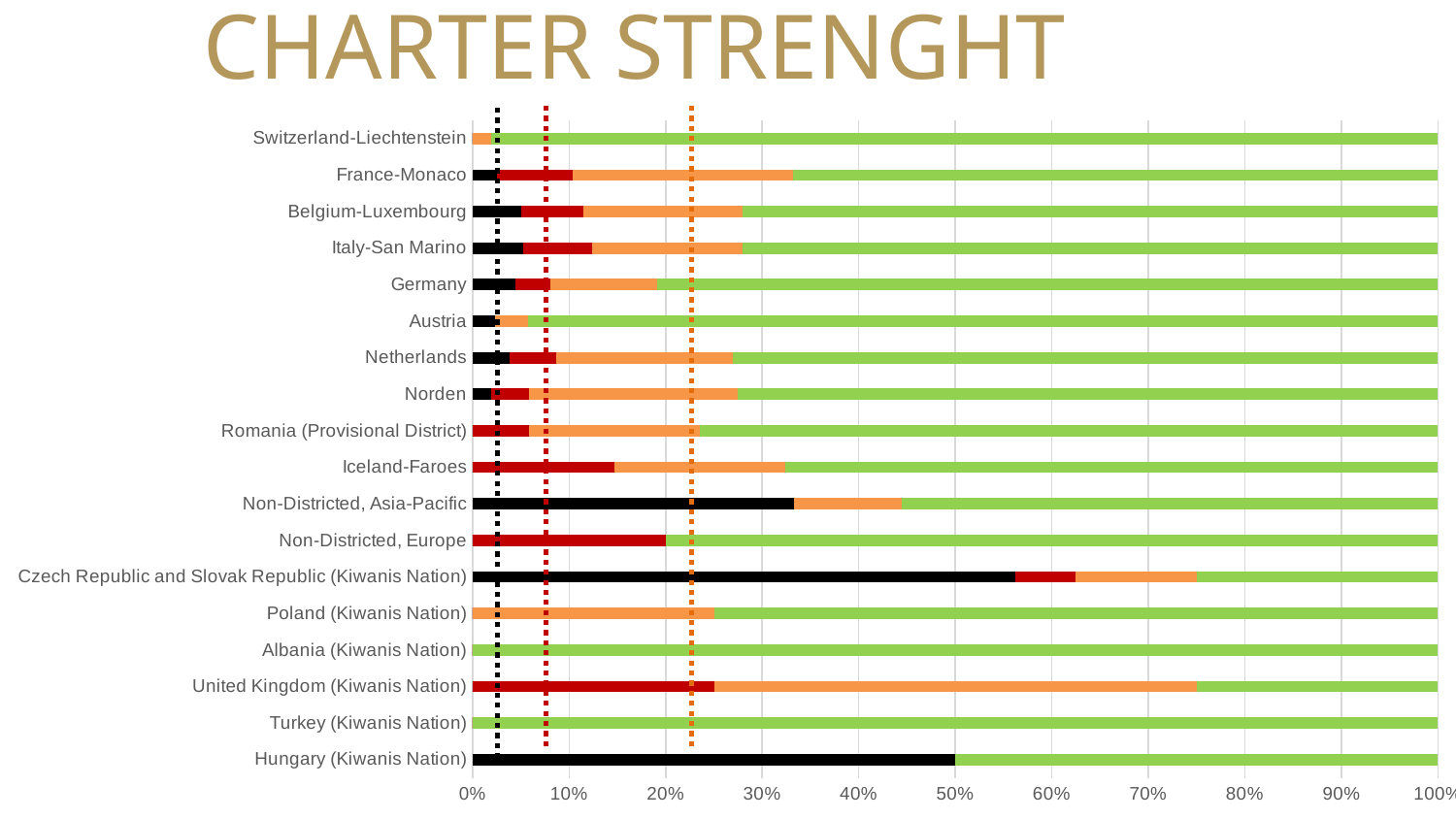
Is the red segment for Iceland-Faroes greater or less than 10%? greater Which category has the largest black segment? Czech Republic and Slovak Republic (Kiwanis Nation) How many dotted vertical reference lines are drawn on the chart? 3 What kind of chart is shown on the slide? Stacked bar chart Is the black segment for Non-Districted, Asia-Pacific greater or less than 30%? greater What is the title of the chart? CHARTER STRENGHT What is the total of the stacked bar for Germany? 100% Is the green segment for Hungary (Kiwanis Nation) greater or less than 40%? greater How many categories (rows) are plotted in the chart? 18 Which has the larger black segment, Czech Republic and Slovak Republic (Kiwanis Nation) or Hungary (Kiwanis Nation)? Czech Republic and Slovak Republic (Kiwanis Nation) Which has the larger orange segment, United Kingdom (Kiwanis Nation) or Poland (Kiwanis Nation)? United Kingdom (Kiwanis Nation)